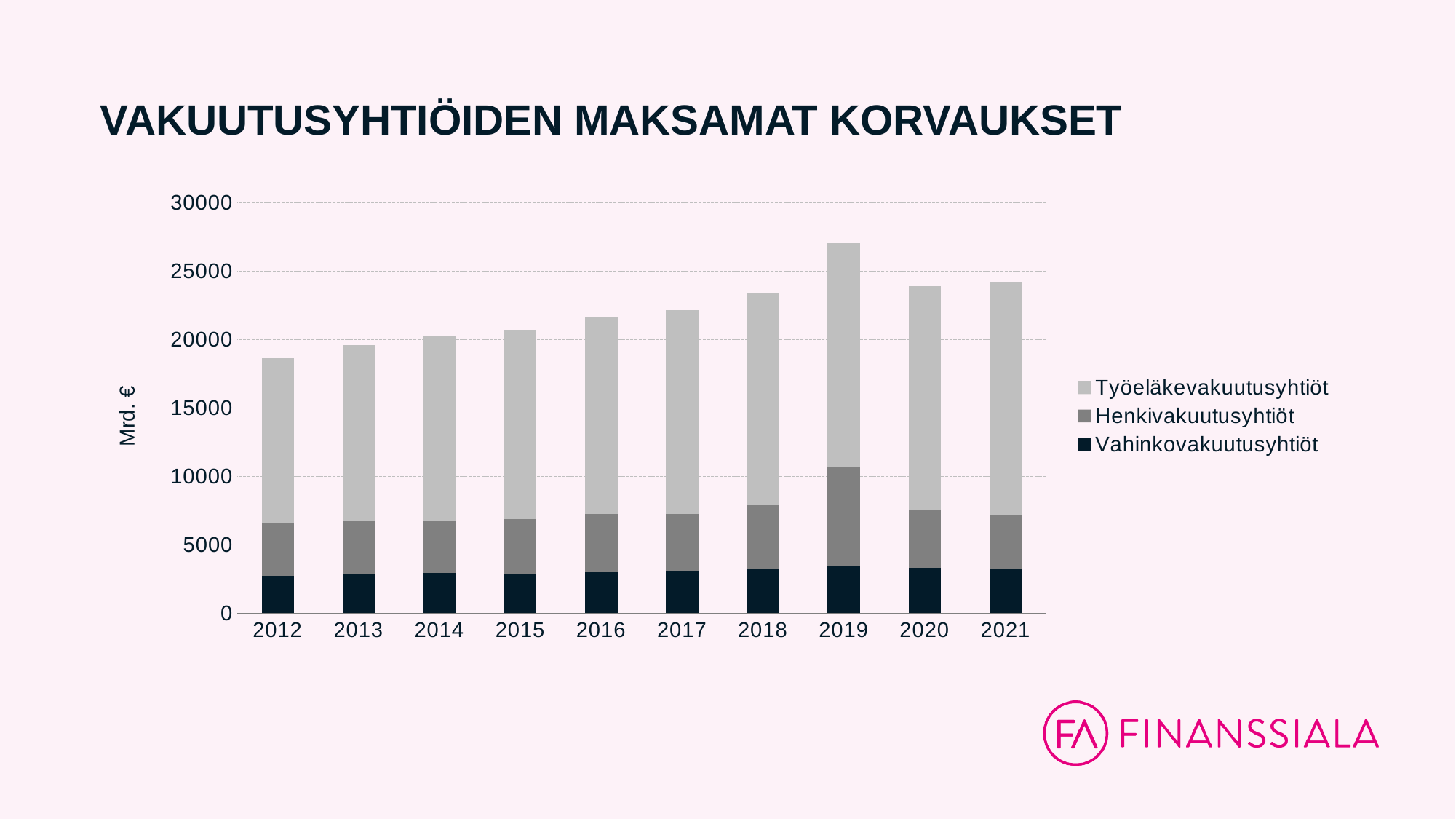
Which year has the highest total bar? 2019 How many years are shown on the x axis of the chart? 10 How many series does the legend list? 3 Which year has the lowest total bar? 2012 What is the label on the vertical axis of the chart? Mrd. € Which legend entry is shown in the darkest colour? Vahinkovakuutusyhtiöt What kind of chart is shown on the slide? Stacked bar chart Is the total value for 2019 greater or less than 25000? greater Is the total value for 2021 greater or less than 25000? less Is the total value for 2012 greater or less than 20000? less Do the total bars generally rise or fall from 2012 to 2019? rise Is the total bar for 2019 larger or smaller than the total bar for 2020? larger